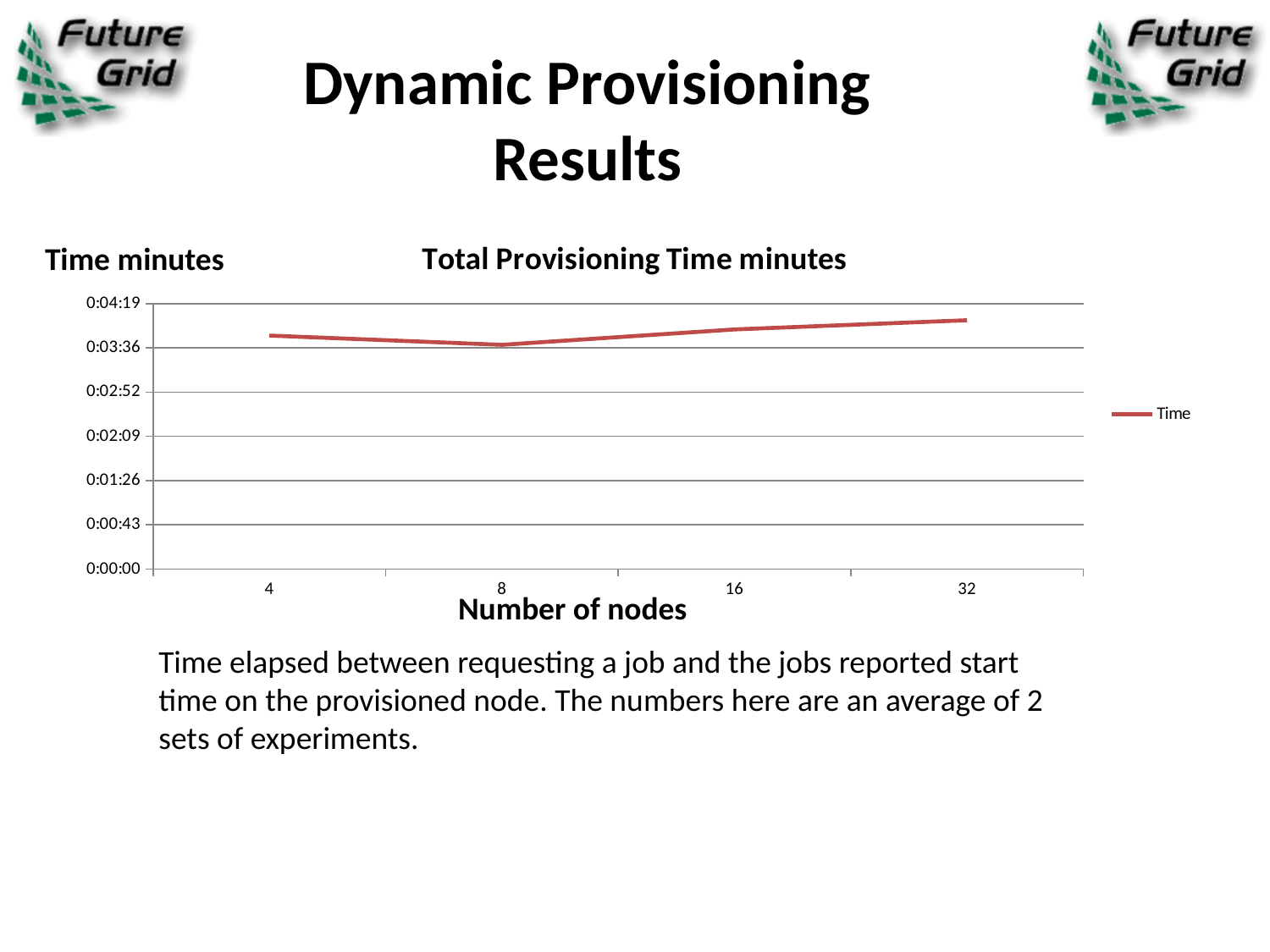
Is the provisioning time for 4 nodes greater or less than 0:02:52? greater At which number of nodes is the provisioning time lowest? 8 Which has a larger provisioning time, 8 nodes or 32 nodes? 32 nodes How many node counts are plotted along the x axis? 4 Is the provisioning time for 32 nodes greater or less than 0:03:36? greater What is the name of the series in the legend? Time What is the title of the chart? Total Provisioning Time minutes What kind of chart is shown on the slide? line chart How many series does the legend list? 1 At which number of nodes is the provisioning time highest? 32 Does the provisioning time rise or fall from 8 nodes to 32 nodes? rise Is the provisioning time for 16 nodes greater or less than 0:04:19? less